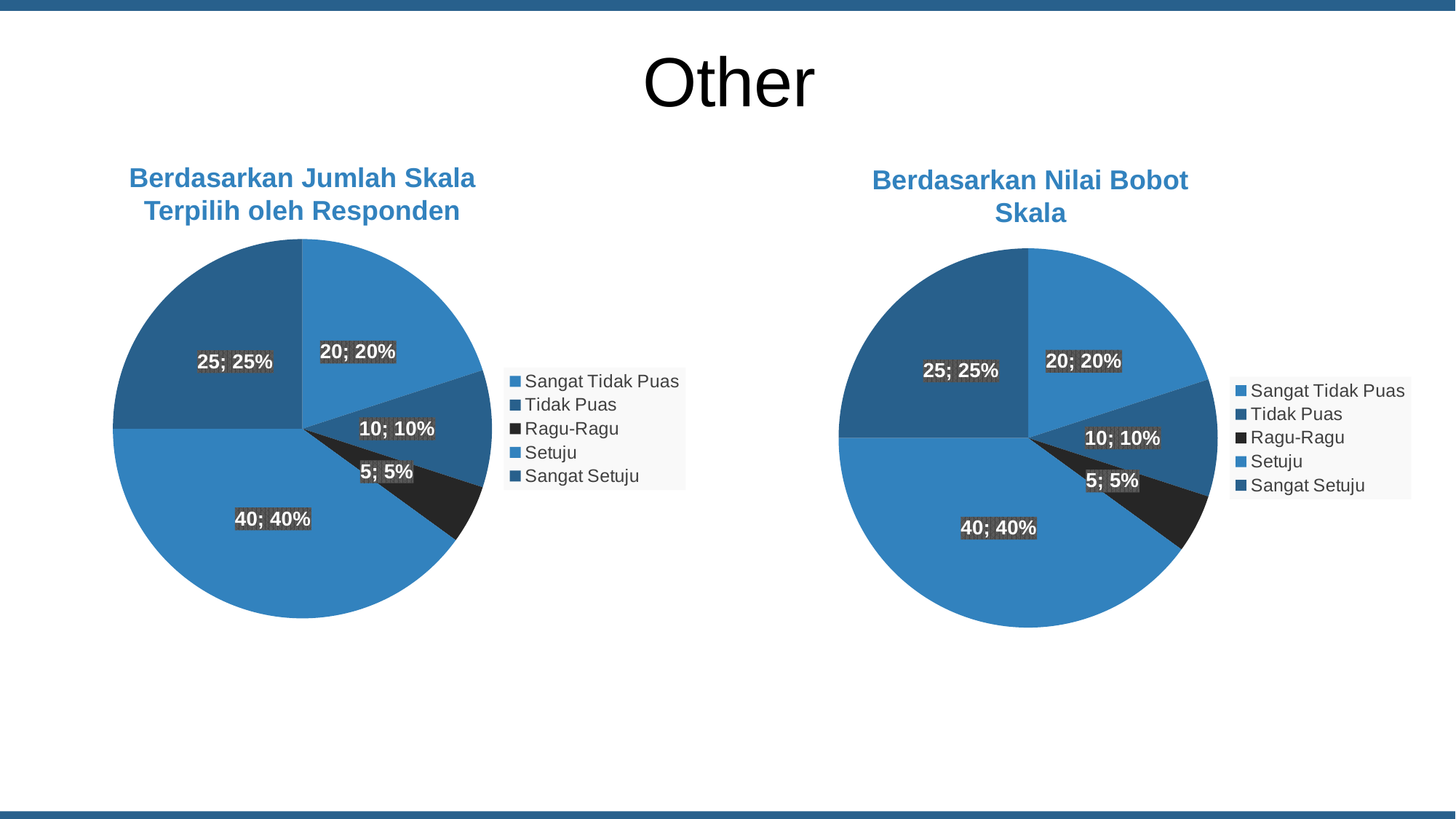
How many slices does the chart titled 'Berdasarkan Nilai Bobot Skala' have? 5 In the right chart, what is the data label on the Tidak Puas slice? 10; 10% In the left chart, which category has the largest slice? Setuju In the right chart, which category has the smallest slice? Ragu-Ragu In the left chart, what is the difference between the Sangat Tidak Puas value and the Tidak Puas value? 10 What is the title of the chart on the right side of the slide? Berdasarkan Nilai Bobot Skala How many entries does the legend of the right chart list? 5 In the chart titled 'Berdasarkan Jumlah Skala Terpilih oleh Responden', what is the data label on the Setuju slice? 40; 40% In the right chart, which is larger, the Sangat Setuju slice or the Sangat Tidak Puas slice? Sangat Setuju What type of chart is the chart titled 'Berdasarkan Jumlah Skala Terpilih oleh Responden'? Pie chart In the chart titled 'Berdasarkan Nilai Bobot Skala', what share of the pie does Sangat Setuju take? 25% In the left chart, what share of the pie does Ragu-Ragu take? 5%